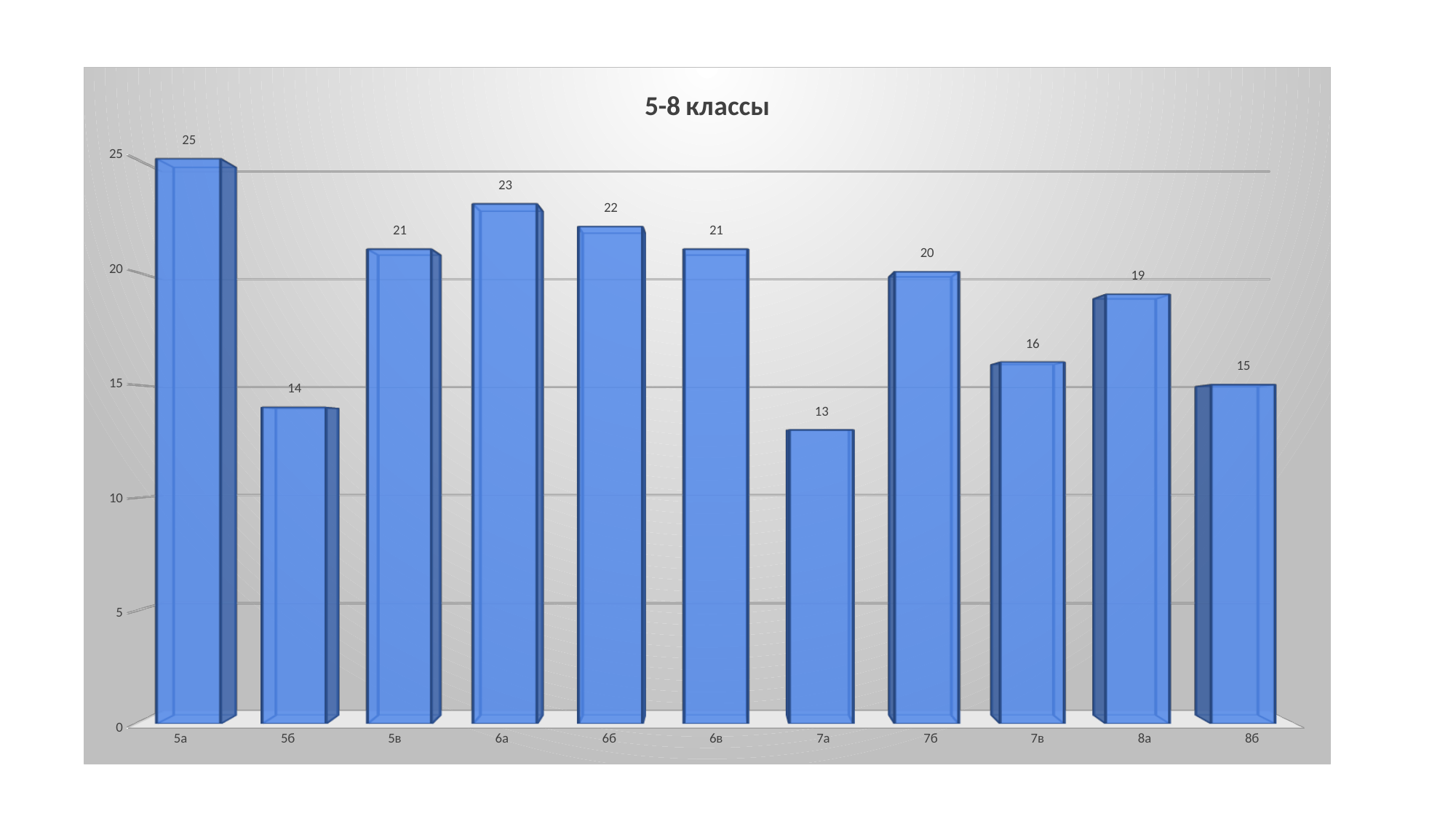
What is the value for 7а? 13 Which category has the lowest value? 7а Is the value for 8б greater or less than 20? less Which category has the highest value? 5а Which is larger, the value for 7б or the value for 7в? 7б What is the value for 8а? 19 What is the title of the chart? 5-8 классы What is the value for 5а? 25 How many categories are shown on the x axis? 11 What is the difference between the values for 6б and 6в? 1 What is the difference between the values for 6а and 5б? 9 What kind of chart is shown on the slide? bar chart